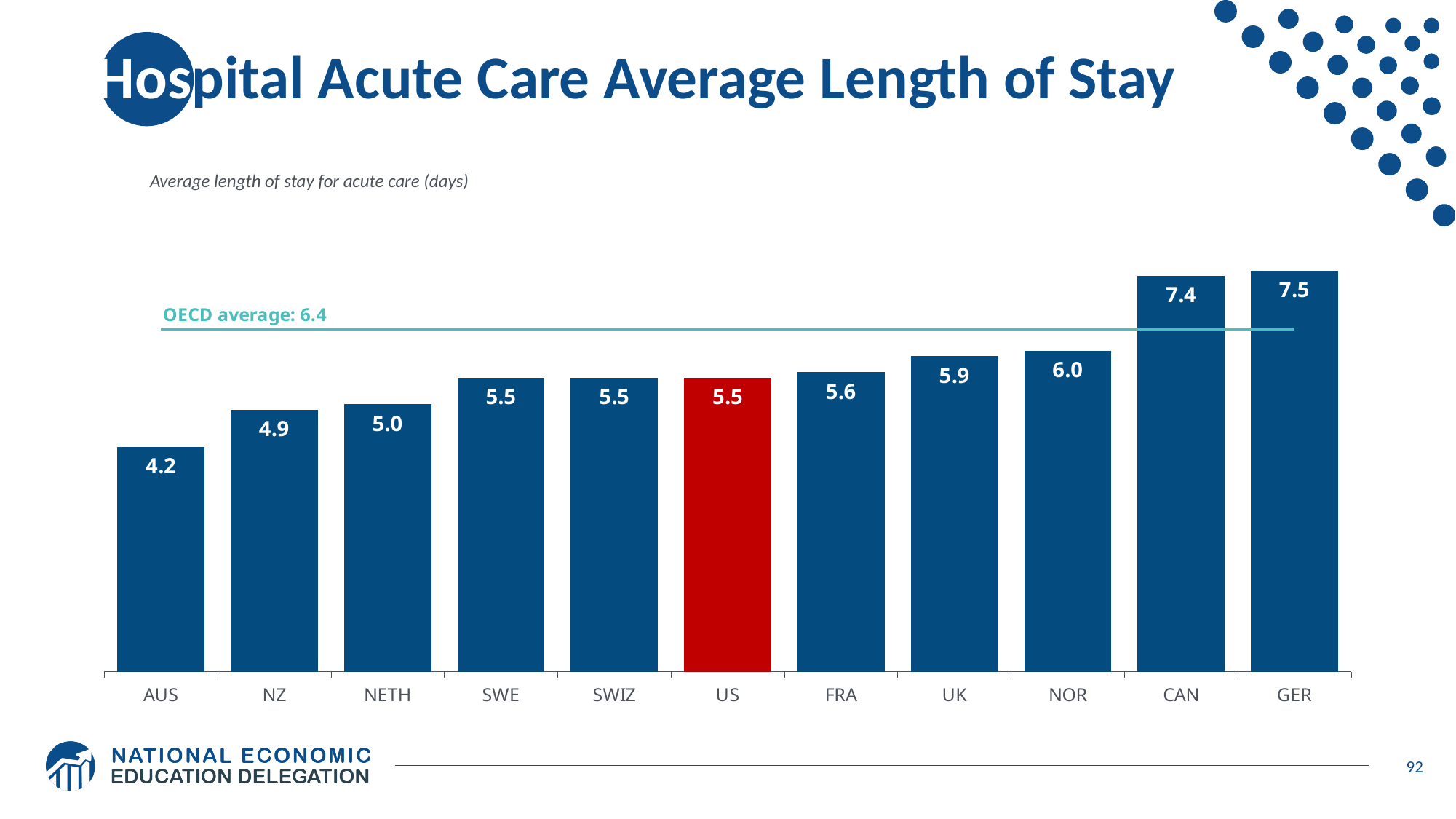
Which has a longer average length of stay, UK or NZ? UK What is the value shown for AUS? 4.2 Which country has the lowest average length of stay for acute care? AUS Which country has the highest average length of stay for acute care? GER What is the difference between the values for NOR and NETH? 1.0 Which country's bar is highlighted in red? US How many countries are shown in the chart? 11 What kind of chart is shown on the slide? Bar chart What is the average length of stay for acute care in Germany (GER)? 7.5 What is the average length of stay for acute care in the US? 5.5 What is the OECD average shown on the chart? 6.4 What is the difference between the values for CAN and AUS? 3.2